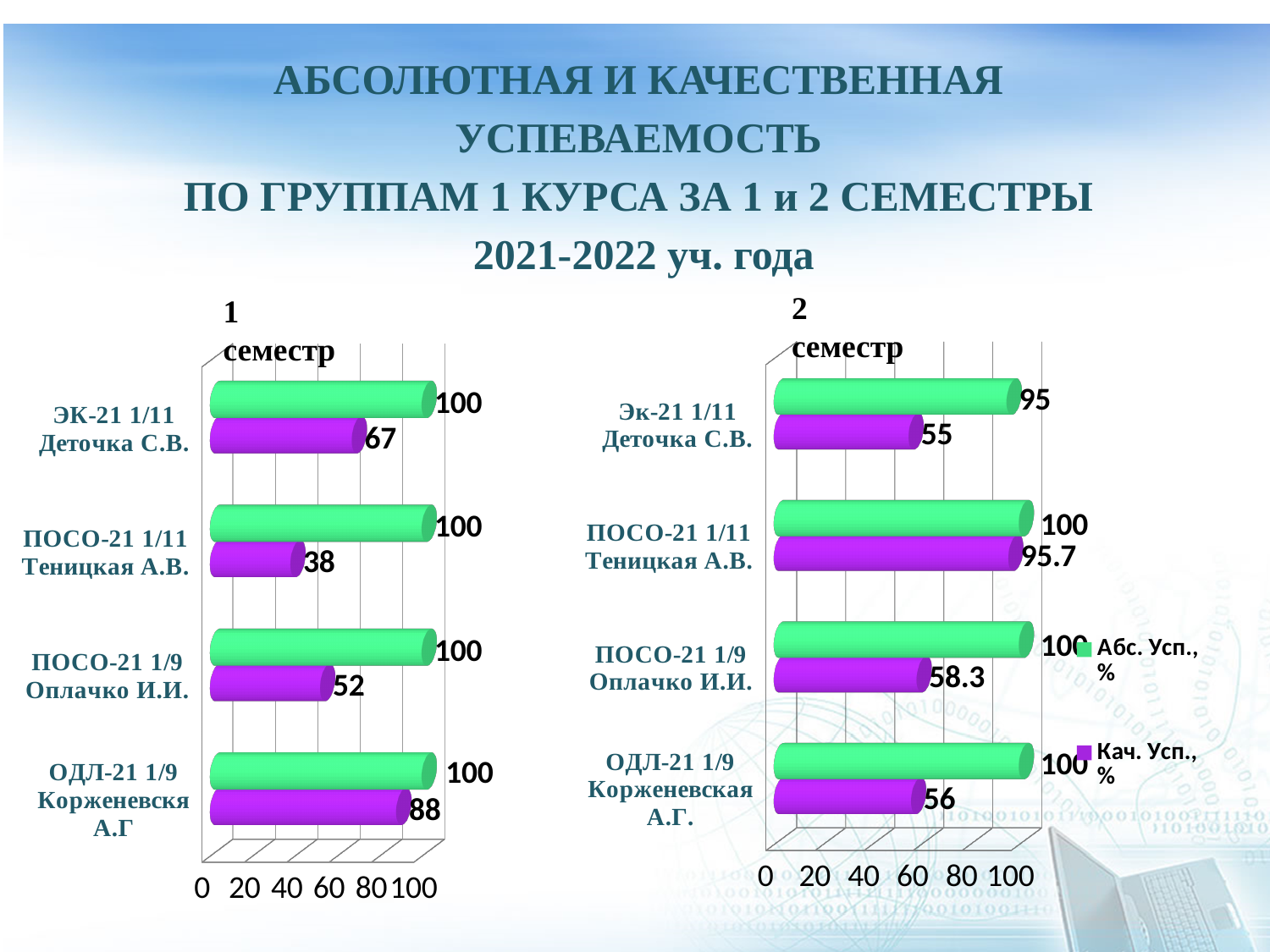
In the '1 семестр' chart, what is the Кач. Усп., % value for ЭК-21 1/11 Деточка С.В.? 67 In the '1 семестр' chart, what is the Кач. Усп., % value for ПОСО-21 1/11 Теницкая А.В.? 38 In the '2 семестр' chart, what is the Кач. Усп., % value for ПОСО-21 1/11 Теницкая А.В.? 95.7 In the '2 семестр' chart, which group has the lowest Абс. Усп., % value? Эк-21 1/11 Деточка С.В. In the '2 семестр' chart, what is the Кач. Усп., % value for ПОСО-21 1/9 Оплачко И.И.? 58.3 In the '1 семестр' chart, which group has the highest Кач. Усп., % value? ОДЛ-21 1/9 Корженевска А.Г In the '1 семестр' chart, what is the difference between the Кач. Усп., % values for ОДЛ-21 1/9 Корженевска А.Г and ПОСО-21 1/9 Оплачко И.И.? 36 How many groups are shown in the '1 семестр' chart? 4 What type of chart is the '2 семестр' chart? bar chart In the '1 семестр' chart, which group has the lowest Кач. Усп., % value? ПОСО-21 1/11 Теницкая А.В. In the '2 семестр' chart, what is the Абс. Усп., % value for Эк-21 1/11 Деточка С.В.? 95 In the '2 семестр' chart, is the Кач. Усп., % value for ОДЛ-21 1/9 Корженевская А.Г. larger or smaller than that for Эк-21 1/11 Деточка С.В.? larger